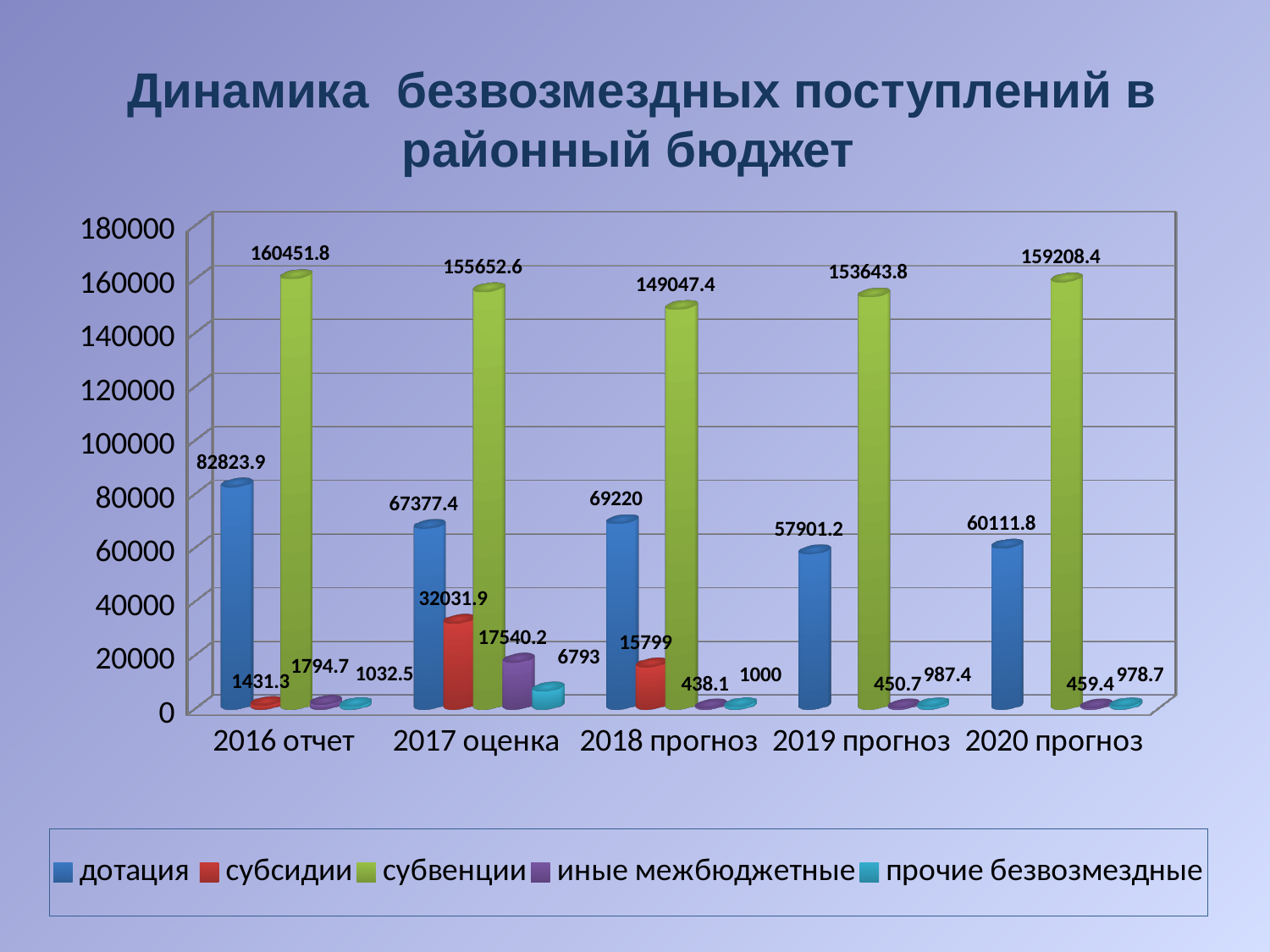
How many series does the legend list? 5 What kind of chart is shown on the slide? bar chart What is the value of субвенции for 2016 отчет? 160451.8 How many categories (years) are shown on the x axis? 5 What is the value of иные межбюджетные for 2017 оценка? 17540.2 What is the value of дотация for 2019 прогноз? 57901.2 What is the value of субсидии for 2017 оценка? 32031.9 In which year is the value of субвенции the lowest? 2018 прогноз What is the difference between the дотация values for 2016 отчет and 2017 оценка? 15446.5 In which year is the value of субвенции the highest? 2016 отчет What is the difference between the субвенции values for 2020 прогноз and 2019 прогноз? 5564.6 Which is larger, the дотация value for 2018 прогноз or for 2020 прогноз? 2018 прогноз